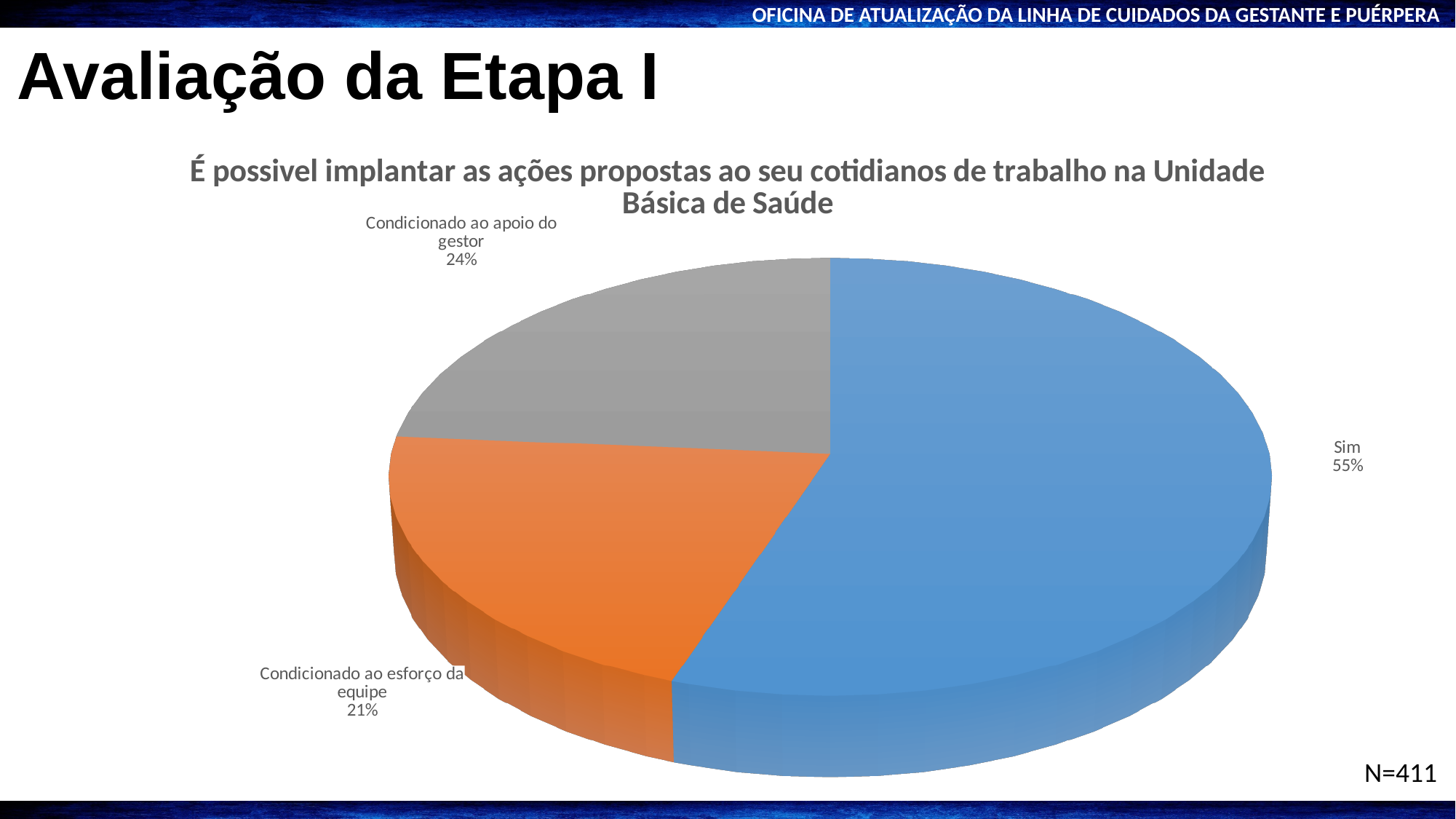
What percentage of respondents answered "Sim"? 55% What is the difference in percentage points between "Sim" and "Condicionado ao apoio do gestor"? 31 How many slices does the pie chart have? 3 What sample size (N) is shown on the slide? N=411 What colour is the "Sim" slice? Blue What is the difference in percentage points between "Condicionado ao apoio do gestor" and "Condicionado ao esforço da equipe"? 3 What percentage is shown for "Condicionado ao apoio do gestor"? 24% Which is larger: the share for "Condicionado ao apoio do gestor" or for "Condicionado ao esforço da equipe"? Condicionado ao apoio do gestor What percentage is shown for "Condicionado ao esforço da equipe"? 21% Which category has the largest share of the pie? Sim Which category has the smallest share of the pie? Condicionado ao esforço da equipe What type of chart is shown on the slide? Pie chart